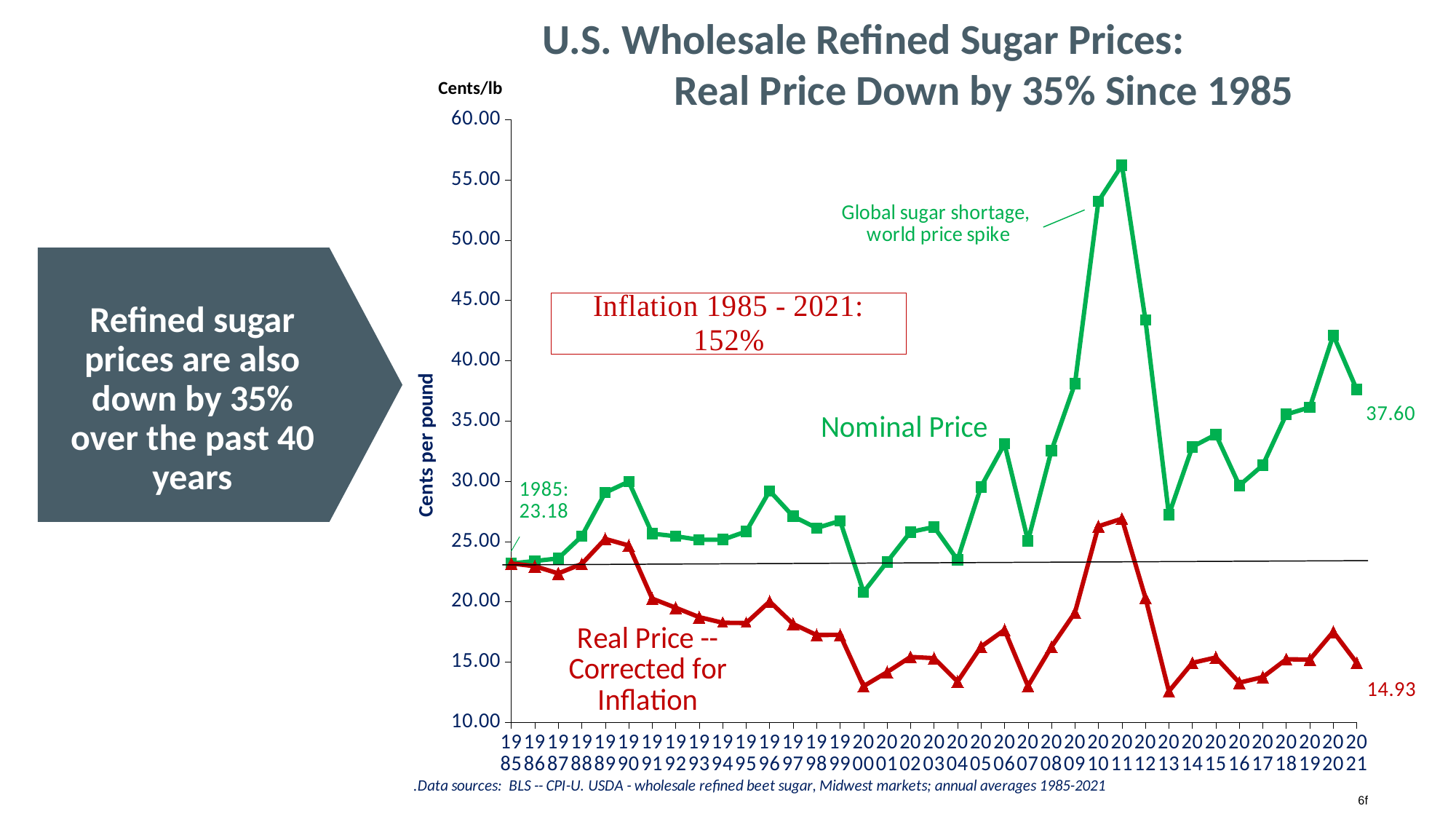
What event does the annotation attribute the 2010-2011 price spike to? Global sugar shortage, world price spike Is the Real Price in 2000 greater or less than 15.00? less What is the Nominal Price in 2021? 37.60 In which year is the Nominal Price at its lowest? 2000 What was the refined sugar price in 1985? 23.18 In which year does the Nominal Price reach its highest value? 2011 What kind of chart is shown on the slide? line chart What is the Real Price (corrected for inflation) in 2021? 14.93 Which is larger, the Nominal Price in 2011 or the Nominal Price in 2020? 2011 Is the Nominal Price in 2011 greater or less than 55.00? greater How many years are plotted on the x axis? 37 What is the difference between the Nominal Price and the Real Price in 2021? 22.67